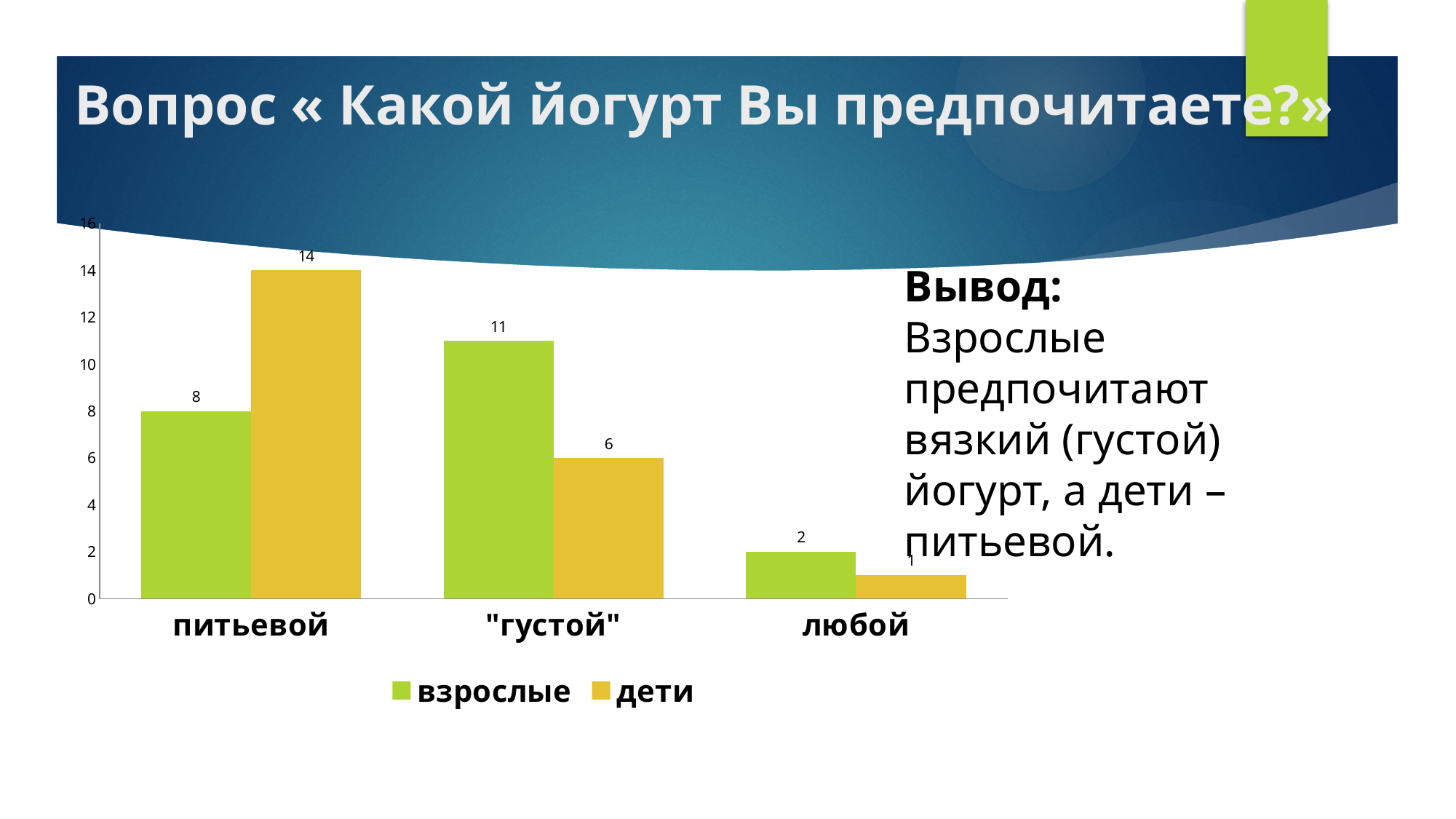
In the "густой" category, which series has the larger value, взрослые or дети? взрослые What is the value for взрослые in the питьевой category? 8 What kind of chart is shown on the slide? bar chart What is the value for дети in the "густой" category? 6 What is the value for дети in the питьевой category? 14 How many series does the legend list? 2 What is the value for взрослые in the "густой" category? 11 What is the value for взрослые in the любой category? 2 Which category has the lowest value for взрослые? любой How many categories are shown on the x axis? 3 What is the difference between the дети and взрослые values in the питьевой category? 6 Which category has the highest value for дети? питьевой